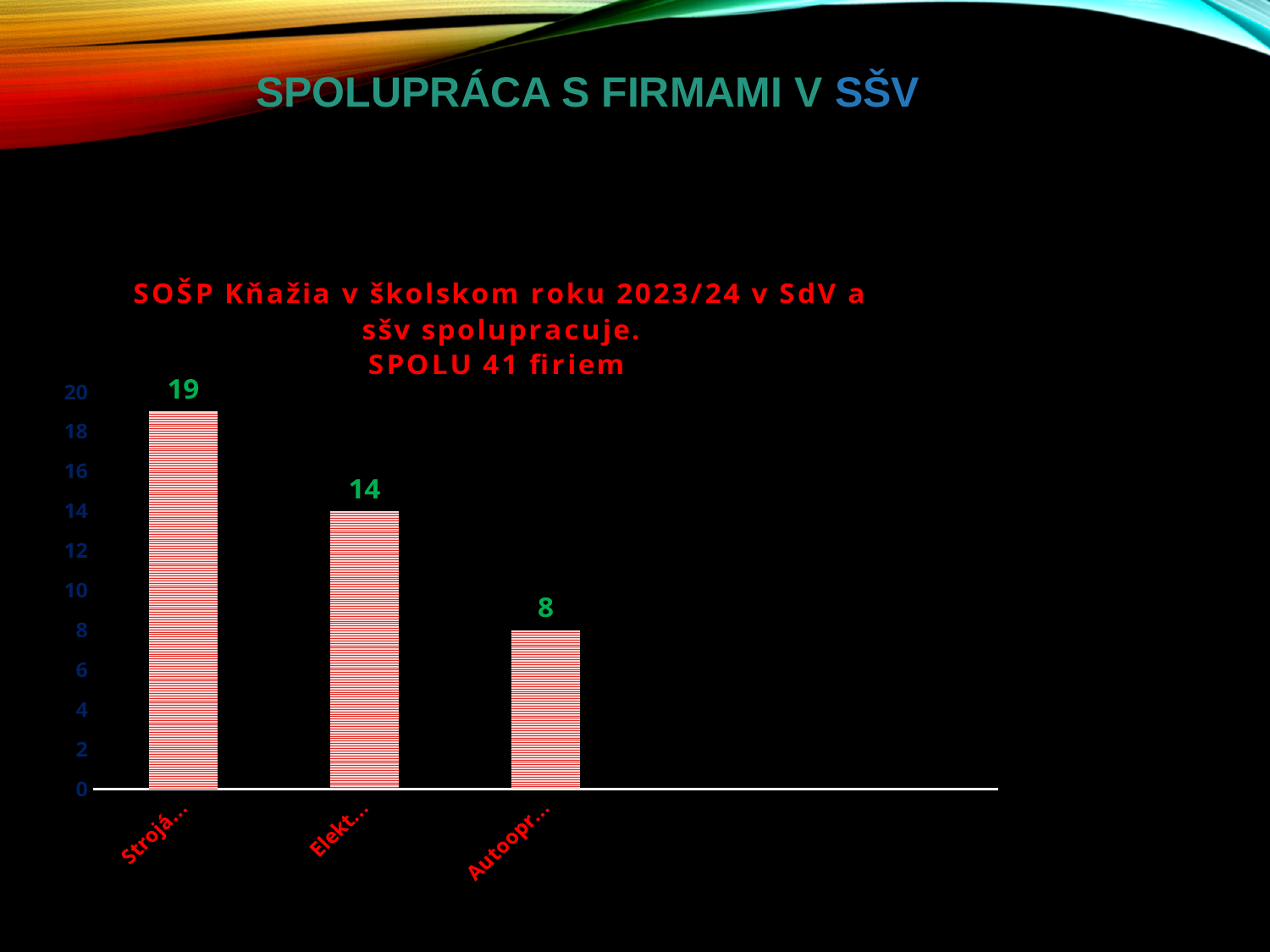
What is the value of the first bar, labelled "Strojá…"? 19 What is the value of the second bar, labelled "Elekt…"? 14 Which bar has the lowest value? Autoopr… (the third bar) According to the chart title, how many firms in total (SPOLU) does the school cooperate with? 41 What is the value of the third bar, labelled "Autoopr…"? 8 What is the difference between the first bar (Strojá…) and the second bar (Elekt…)? 5 Which is larger, the value for Elekt… or the value for Autoopr…? Elekt… What is the difference between the second bar (Elekt…) and the third bar (Autoopr…)? 6 Which bar has the highest value? Strojá… (the first bar) What type of chart is shown on the slide? bar chart How many bars (categories) does the chart show? 3 Do the bar values rise or fall from left to right along the x axis? fall